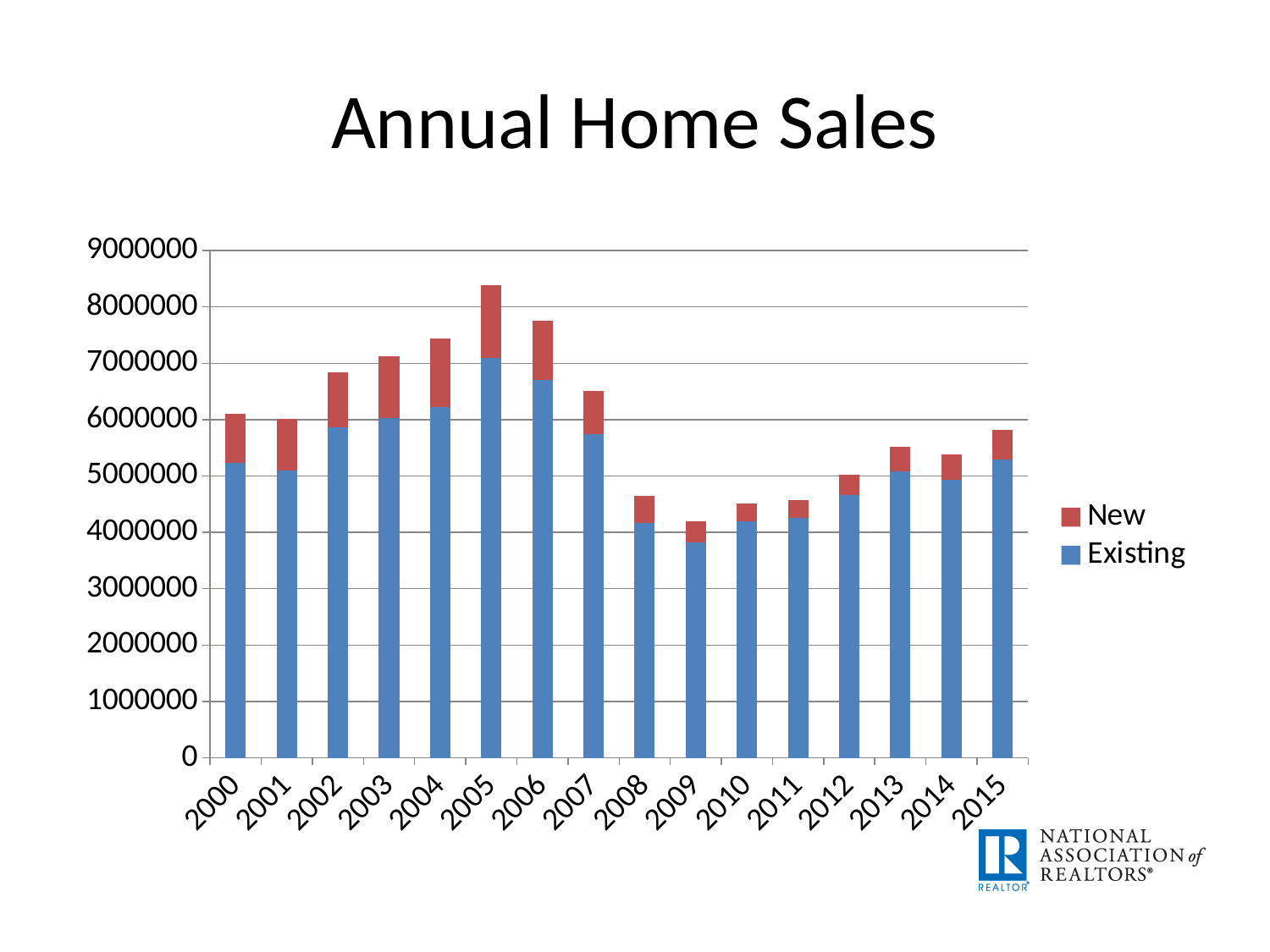
Which year has the highest total home sales? 2005 What is the title of the chart? Annual Home Sales Which colour represents the New series in the legend? red Is the Existing home sales value for 2006 greater or less than 7000000? less How many years are shown on the x axis? 16 Which year has higher total home sales, 2005 or 2006? 2005 Which year has the lowest total home sales? 2009 What kind of chart is shown on the slide? bar chart Is the total home sales value for 2009 greater or less than 5000000? less Is the total home sales value for 2005 greater or less than 8000000? greater Do total home sales rise or fall from 2005 to 2009? fall How many series does the legend list? 2